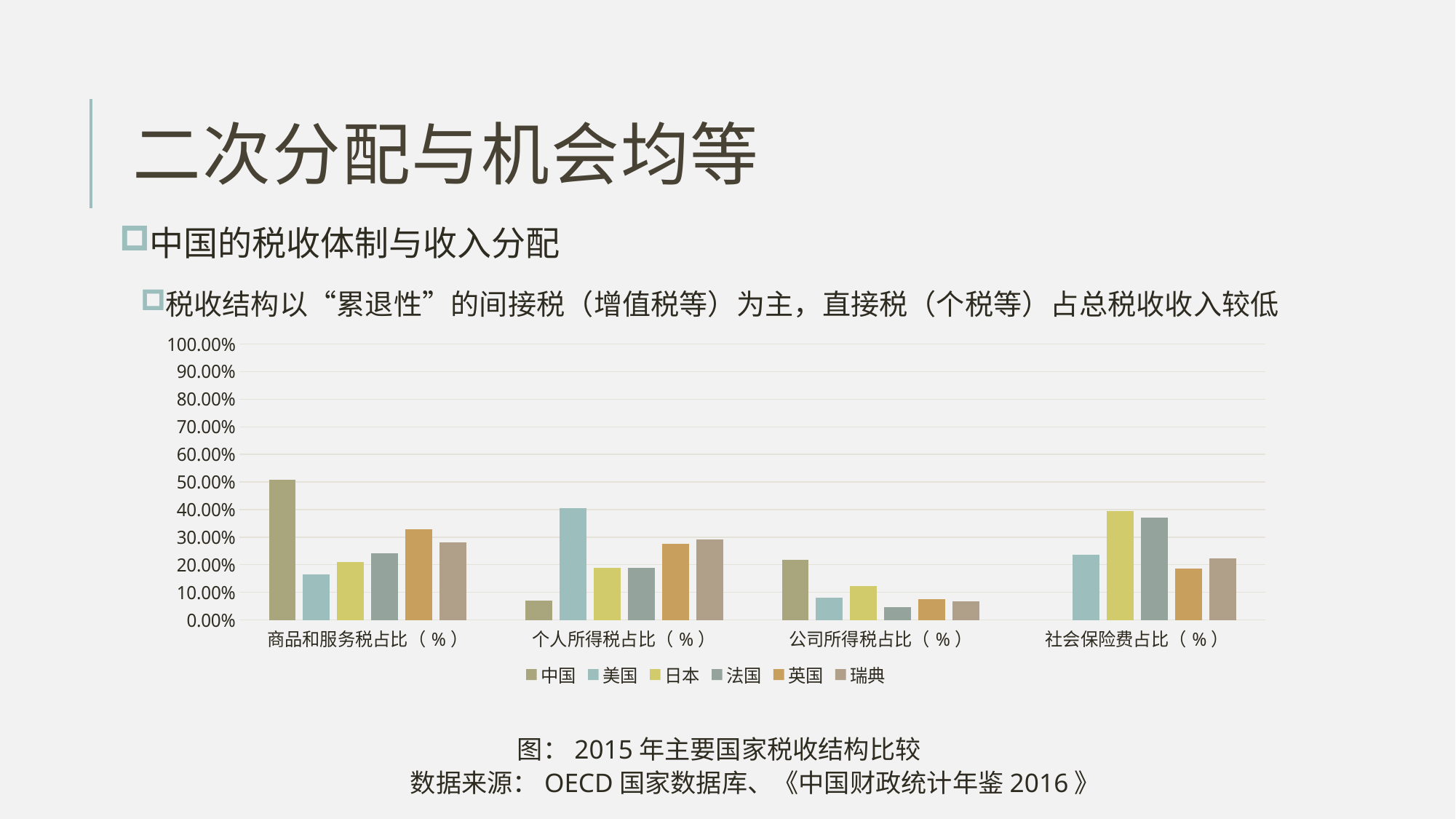
Which country has the highest value for 公司所得税占比（%）? 中国 Which country has the highest value for 商品和服务税占比（%）? 中国 In 社会保险费占比（%）, which is larger: the value for 日本 or the value for 英国? 日本 Is the value for 美国 in 个人所得税占比（%） greater or less than 30.00%? greater What kind of chart is shown on the slide? bar chart Which country has the lowest value for 公司所得税占比（%）? 法国 How many tax categories are shown along the x axis of the chart? 4 Which country has the lowest value for 商品和服务税占比（%）? 美国 Which country has the lowest value for 个人所得税占比（%）? 中国 Is the value for 中国 in 商品和服务税占比（%） greater or less than 40.00%? greater Which country has the highest value for 个人所得税占比（%）? 美国 How many countries (series) does the chart legend list? 6